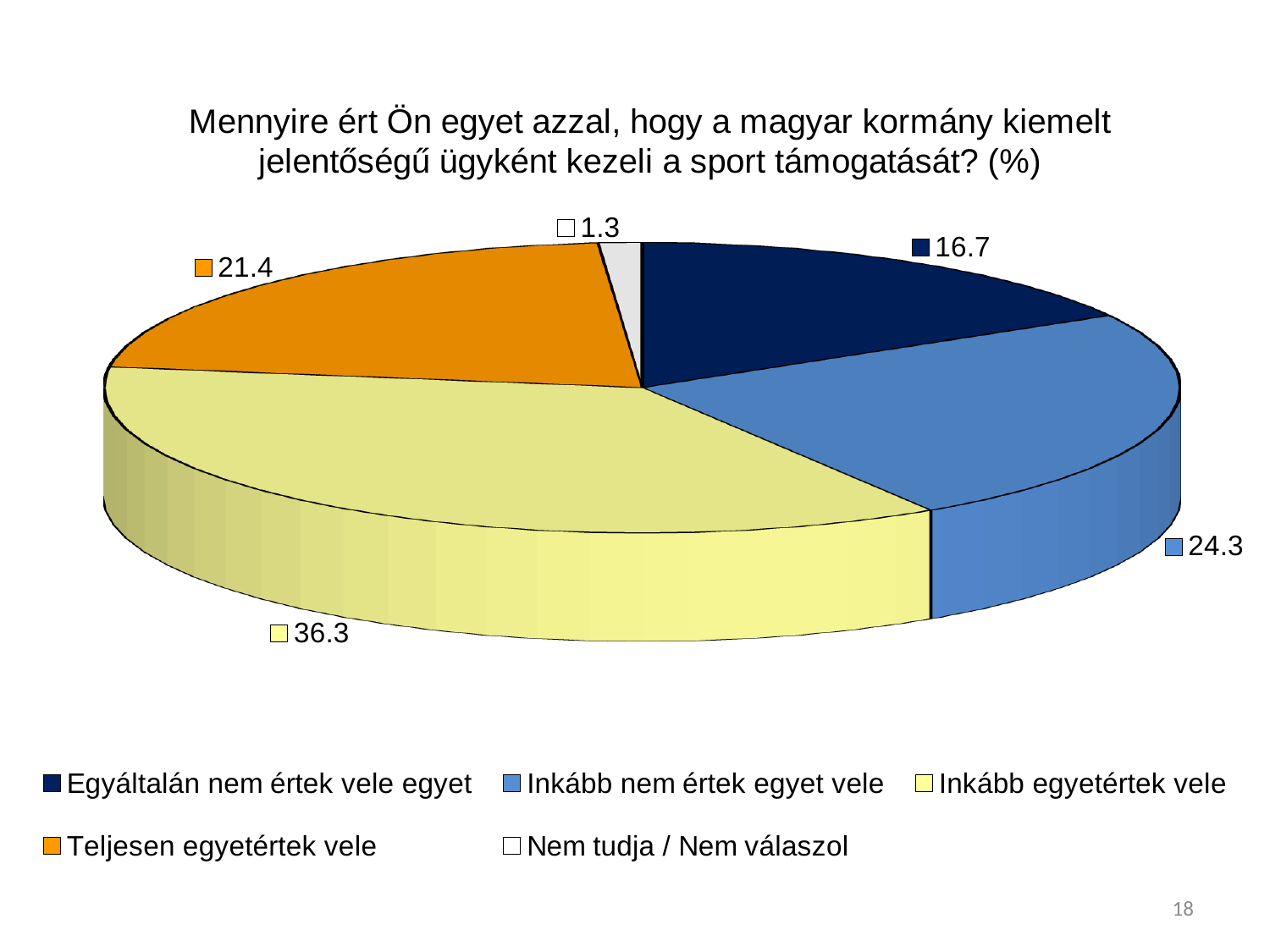
What is the combined value of "Inkább egyetértek vele" and "Teljesen egyetértek vele"? 57.7 What is the value for "Egyáltalán nem értek vele egyet"? 16.7 What is the value for "Nem tudja / Nem válaszol"? 1.3 What type of chart is shown on the slide? pie chart Which category has the smallest slice of the pie? Nem tudja / Nem válaszol How many categories does the pie chart have? 5 What is the difference between the values for "Inkább egyetértek vele" and "Inkább nem értek egyet vele"? 12.0 Which is larger, the value for "Inkább nem értek egyet vele" or the value for "Teljesen egyetértek vele"? Inkább nem értek egyet vele Which category has the largest slice of the pie? Inkább egyetértek vele Which colour represents "Teljesen egyetértek vele" in the pie chart? orange What is the value for "Inkább egyetértek vele"? 36.3 What is the value for "Teljesen egyetértek vele"? 21.4